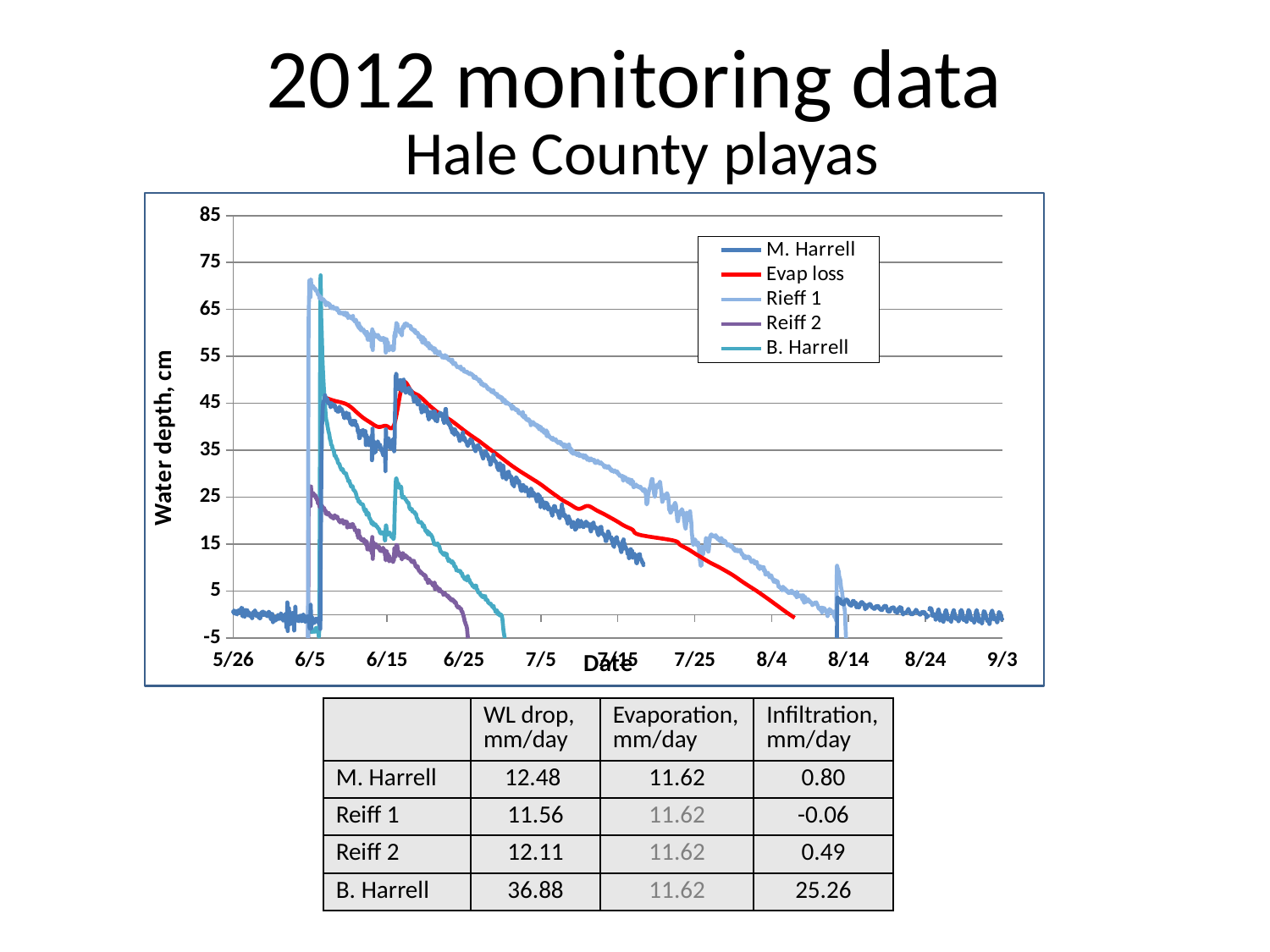
Is the value of the M. Harrell series around 7/15 greater or less than 25? less Does the Rieff 1 series rise or fall between 6/7 and 8/14? fall Does the Evap loss series rise or fall between 6/17 and 8/7? fall What kind of chart is shown on the slide? line chart Is the peak value of the Reiff 2 series greater or less than 35? less Is the peak value of the Rieff 1 series around 6/5 greater or less than 65? greater Around 6/20, which series has the higher water depth, Reiff 2 or B. Harrell? B. Harrell What is the title of the vertical axis of the chart? Water depth, cm Around 7/5, which series has the higher water depth, Rieff 1 or M. Harrell? Rieff 1 Which series in the chart is drawn in red? Evap loss How many series does the chart legend list? 5